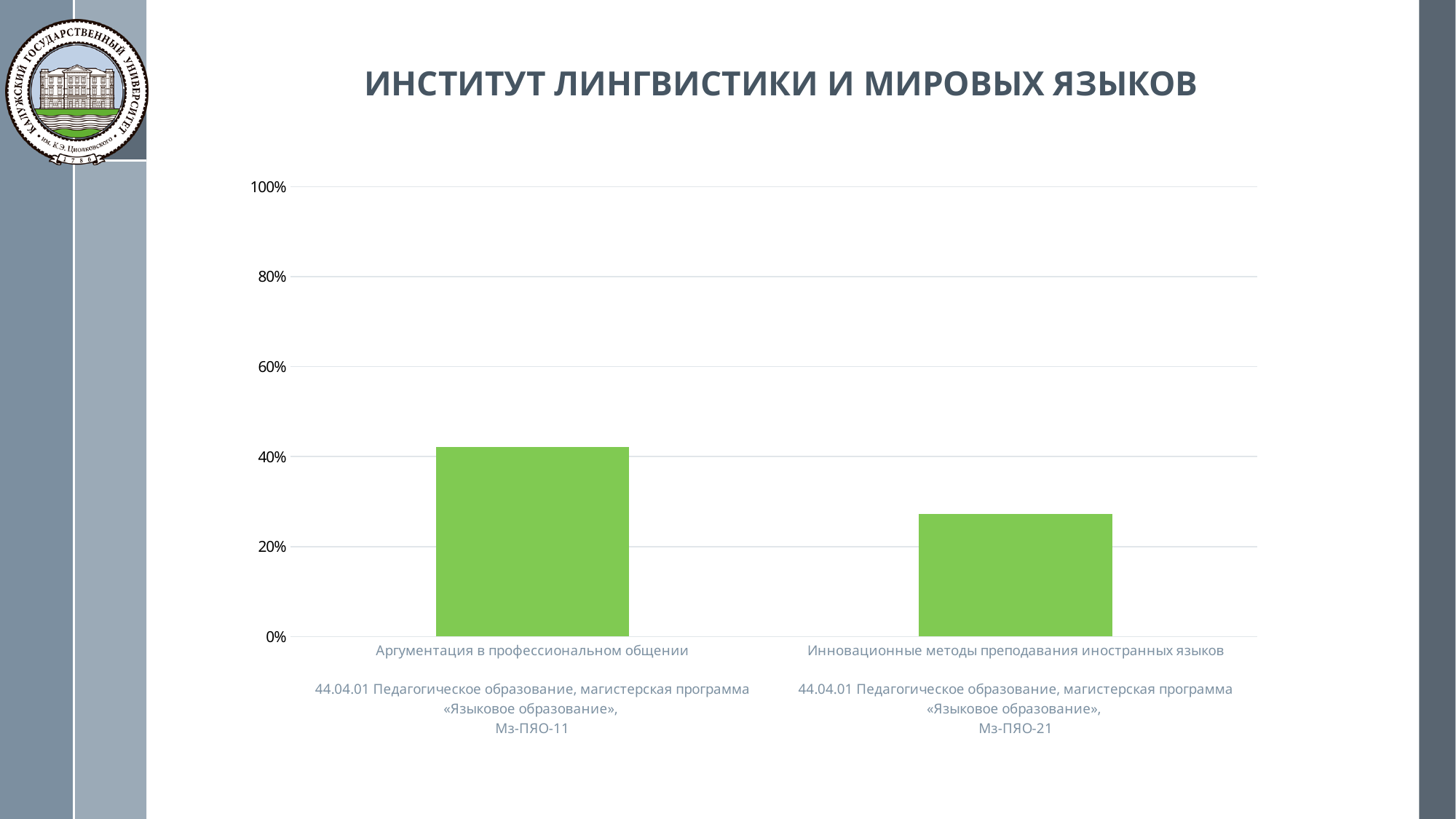
Is the value for «Инновационные методы преподавания иностранных языков» greater or less than 20%? greater Is the value for «Аргументация в профессиональном общении» greater or less than 60%? less What is the highest value shown on the vertical axis? 100% What kind of chart is shown on the slide? bar chart Which is larger: the value for «Аргументация в профессиональном общении» or the value for «Инновационные методы преподавания иностранных языков»? Аргументация в профессиональном общении What colour are the bars in the chart? green Is the value for «Аргументация в профессиональном общении» greater or less than 20%? greater Which category has the lowest bar? Инновационные методы преподавания иностранных языков Which category has the highest bar? Аргументация в профессиональном общении Do the bar values rise or fall from left to right along the x axis? fall How many bars (categories) does the chart show? 2